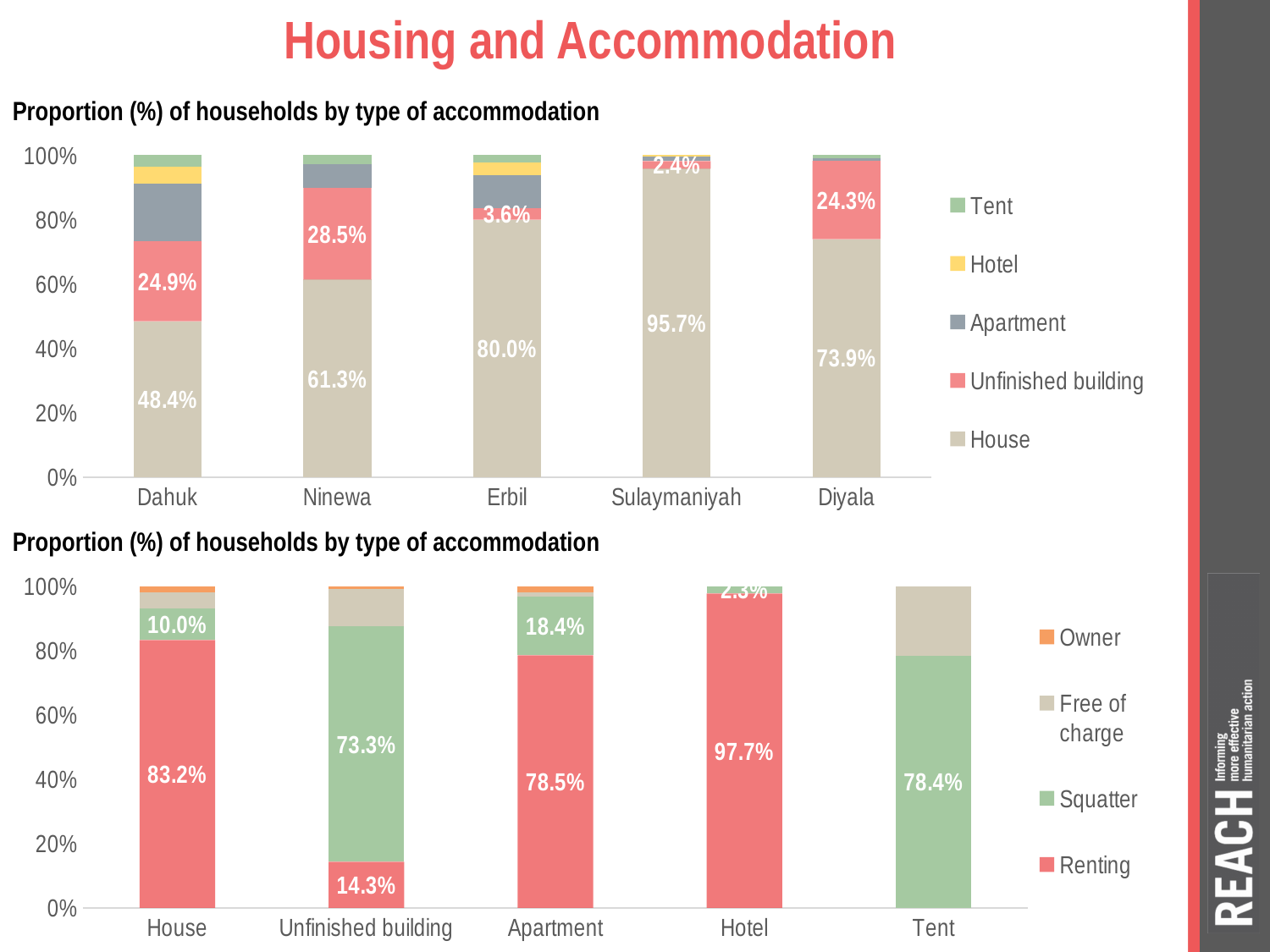
In the top chart, what is the Unfinished building share for Ninewa? 28.5% In the bottom chart, how many accommodation categories are shown on the x axis? 5 In the top chart, which governorate has the lowest House share? Dahuk In the bottom chart, which is larger: the Renting share for House or the Renting share for Apartment? House In the top chart, is the House share for Diyala greater or less than 60%? greater In the bottom chart, what is the Renting share for Hotel? 97.7% What type of chart is the bottom chart? Stacked bar chart In the top chart, how many series does the legend list? 5 In the bottom chart, what is the Squatter share for Tent? 78.4% In the top chart, which governorate has the highest House share? Sulaymaniyah In the top chart, what is the difference between the House share in Erbil and the House share in Ninewa? 18.7% In the top chart, what percentage of households in Dahuk live in a house? 48.4%